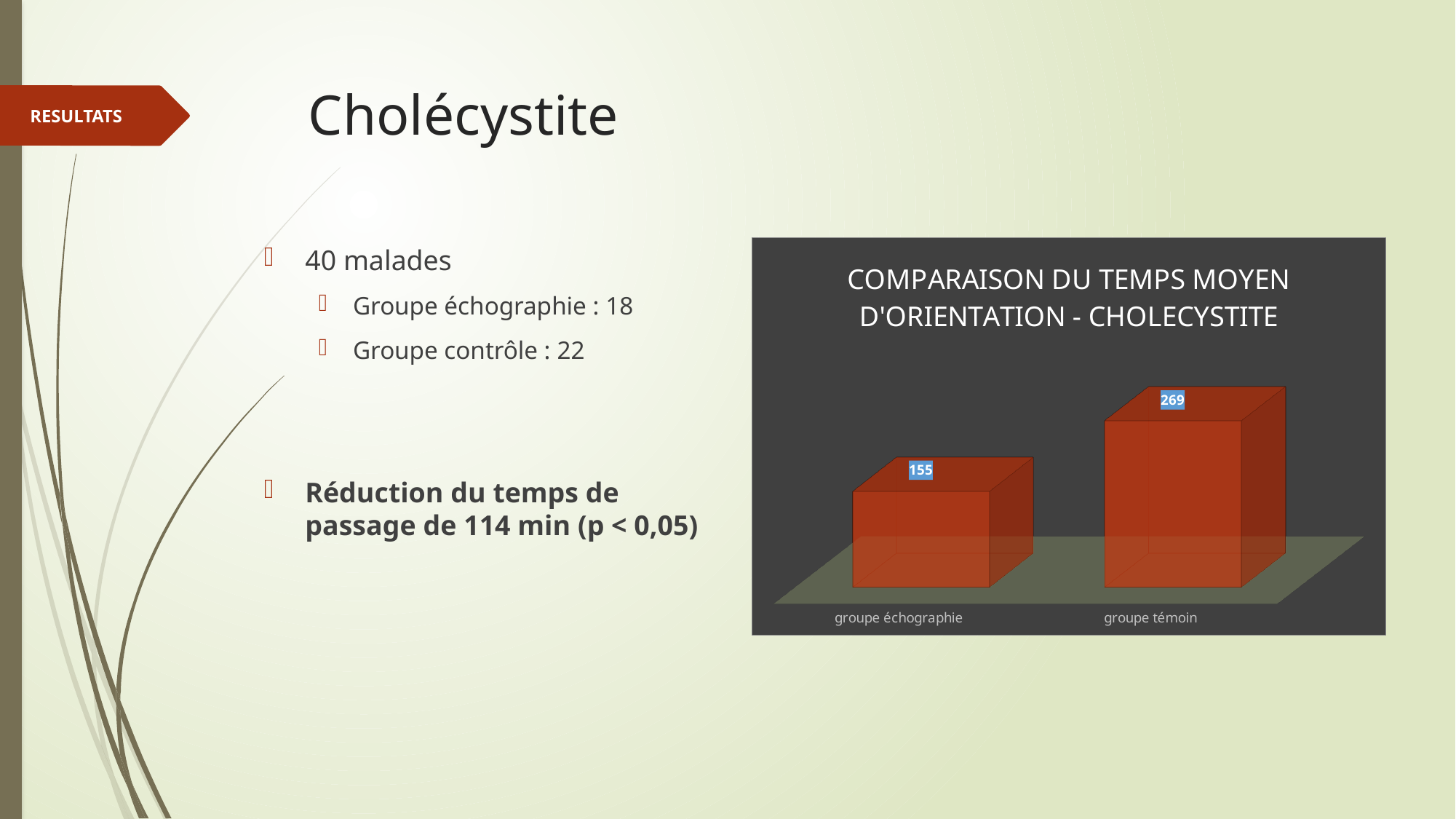
What is the difference between the values for groupe témoin and groupe échographie? 114 What is the value for groupe échographie? 155 Which category has the lowest value? groupe échographie Which category has the highest value? groupe témoin Which is larger, the value for groupe échographie or the value for groupe témoin? groupe témoin What colour are the bars in the chart? red Do the values rise or fall from groupe échographie to groupe témoin? rise How many categories are shown in the chart? 2 What is the value for groupe témoin? 269 What is the title of the chart? COMPARAISON DU TEMPS MOYEN D'ORIENTATION - CHOLECYSTITE What kind of chart is shown on the slide? bar chart